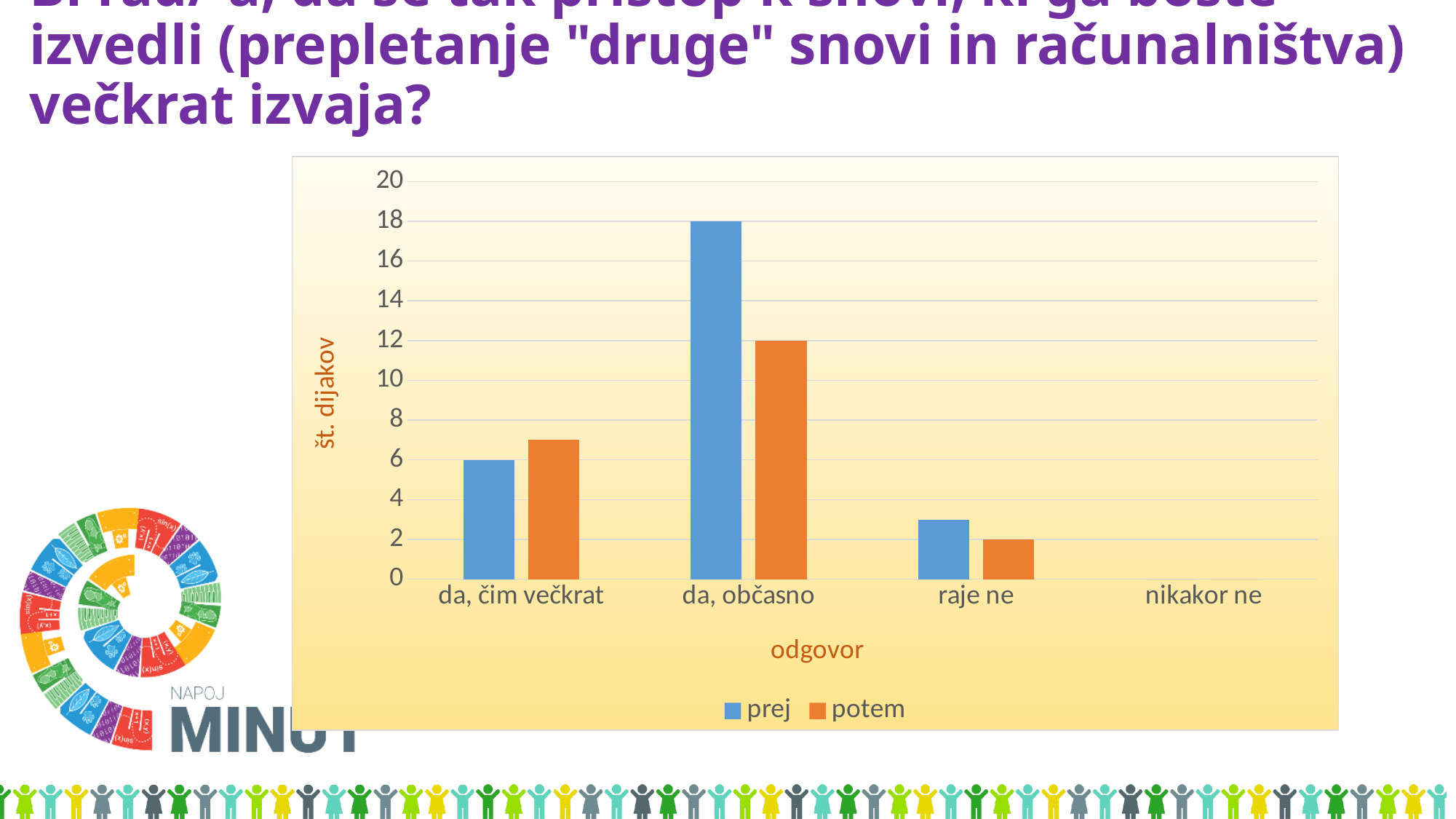
Which answer category has the highest value in the "prej" series? da, občasno How many series does the legend list? 2 What is the value of the "prej" series for "da, čim večkrat"? 6 What is the title of the vertical axis? št. dijakov Is the "prej" value for "raje ne" greater or less than 4? less What is the value of the "potem" series for "da, občasno"? 12 For "da, čim večkrat", which series has the larger value, "prej" or "potem"? potem Is the "potem" value for "da, čim večkrat" greater or less than 8? less What is the difference between the "prej" and "potem" values for "da, občasno"? 6 What is the value of the "prej" series for "da, občasno"? 18 How many answer categories are shown on the x axis? 4 What is the value of the "potem" series for "raje ne"? 2